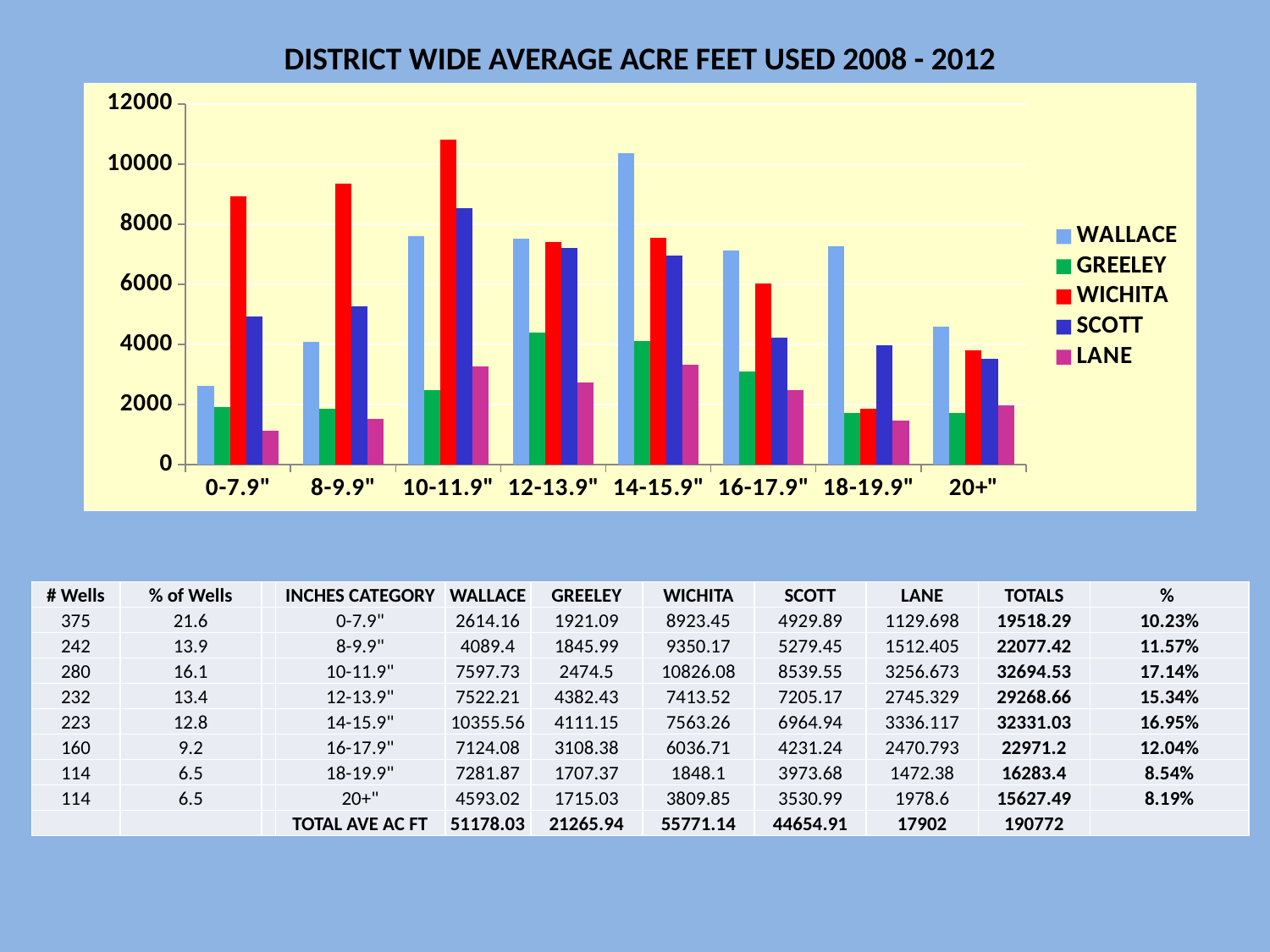
What is the title of the chart? DISTRICT WIDE AVERAGE ACRE FEET USED 2008 - 2012 How many series does the chart legend list? 5 Do the LANE values rise or fall from the 0-7.9" category to the 10-11.9" category? rise What colour are the WICHITA bars in the chart? red What kind of chart is shown on the slide? bar chart Is the SCOTT value for the 0-7.9" category greater or less than 4000? greater How many inches categories are shown along the x axis of the chart? 8 What is the WICHITA value for the 10-11.9" category? 10826.08 In which inches category is the WALLACE value highest? 14-15.9" What is the difference between the WICHITA and WALLACE values in the 0-7.9" category? 6309.29 In the 14-15.9" category, which is larger, WALLACE or WICHITA? WALLACE In which inches category is the WICHITA value lowest? 18-19.9"